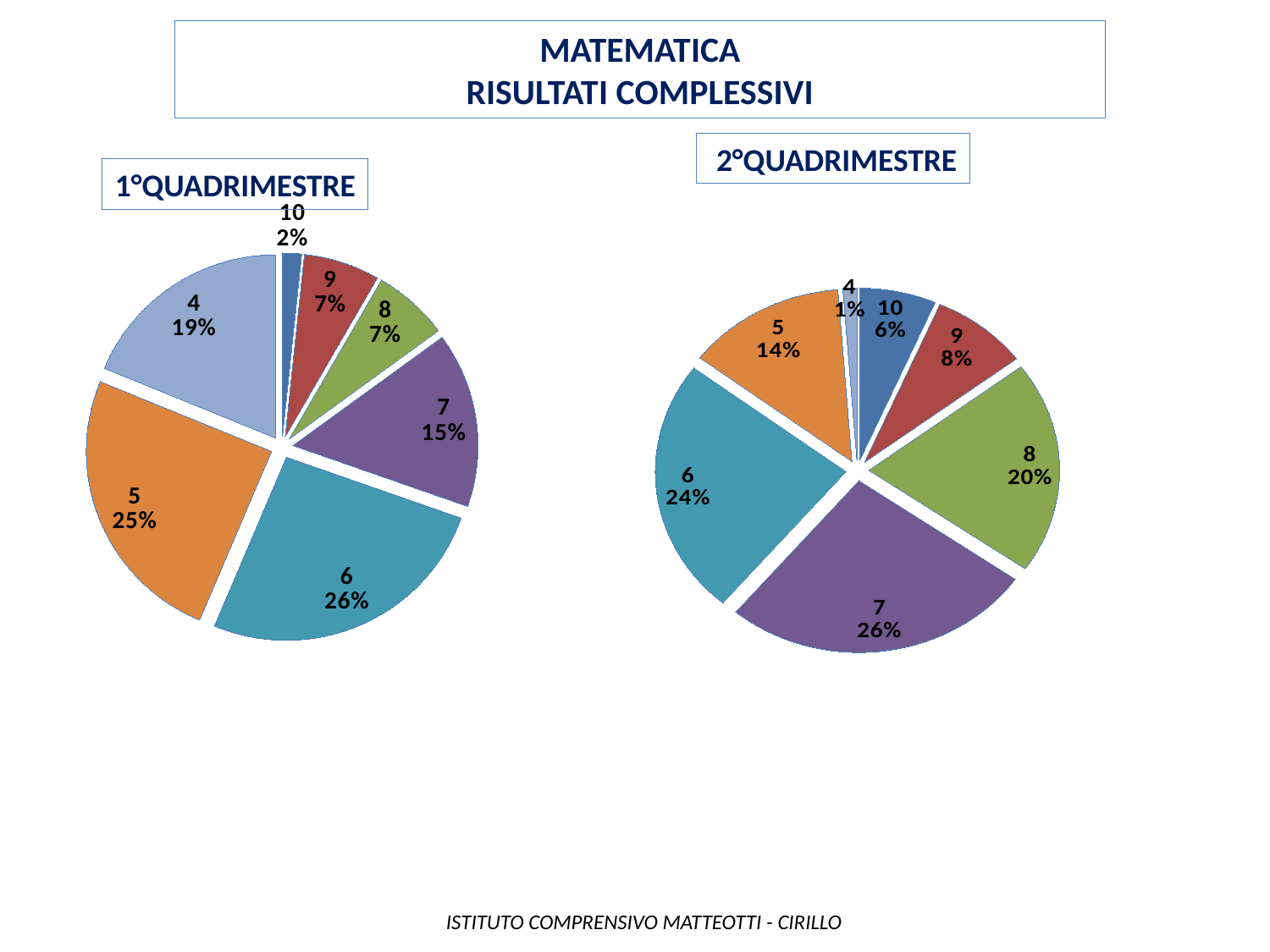
How many slices does the 1°QUADRIMESTRE chart have? 7 What kind of chart is the 2°QUADRIMESTRE chart? Pie chart In the 2°QUADRIMESTRE chart, what share does grade 8 have? 20% What is the title shown above both charts? MATEMATICA RISULTATI COMPLESSIVI In the 1°QUADRIMESTRE chart, which grade has the smallest slice? 10 In the 2°QUADRIMESTRE chart, which grade has the smallest slice? 4 In the 1°QUADRIMESTRE chart, which grade has the largest slice? 6 In the 1°QUADRIMESTRE chart, what share does grade 6 have? 26% In the 2°QUADRIMESTRE chart, which grade has the largest slice? 7 In the 2°QUADRIMESTRE chart, what is the difference between the shares of grade 7 and grade 6? 2% In the 1°QUADRIMESTRE chart, which is larger: the share of grade 4 or the share of grade 7? 4 In the 1°QUADRIMESTRE chart, what share does grade 9 have? 7%